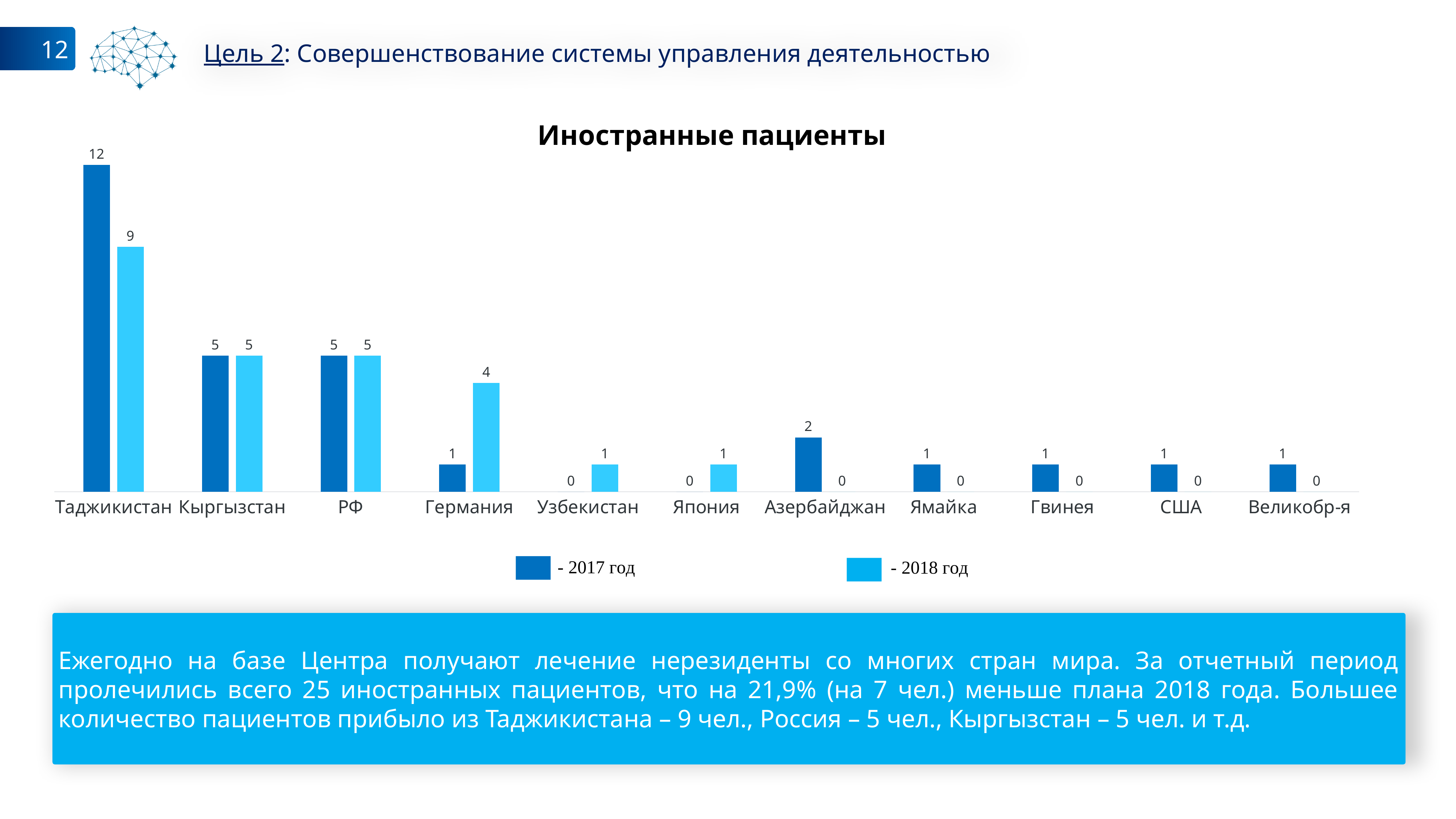
What is the value for Таджикистан in 2018 год? 9 How many series does the legend list? 2 Which country has the highest value in 2017 год? Таджикистан What type of chart is shown on the slide? bar chart What is the value for Таджикистан in 2017 год? 12 What is the title of the chart? Иностранные пациенты What is the value for Азербайджан in 2017 год? 2 What is the value for Узбекистан in 2017 год? 0 Which is larger for Германия: the 2017 год value or the 2018 год value? 2018 год How many countries are shown on the x axis of the chart? 11 What is the value for Германия in 2018 год? 4 What is the difference between the 2017 год and 2018 год values for Таджикистан? 3